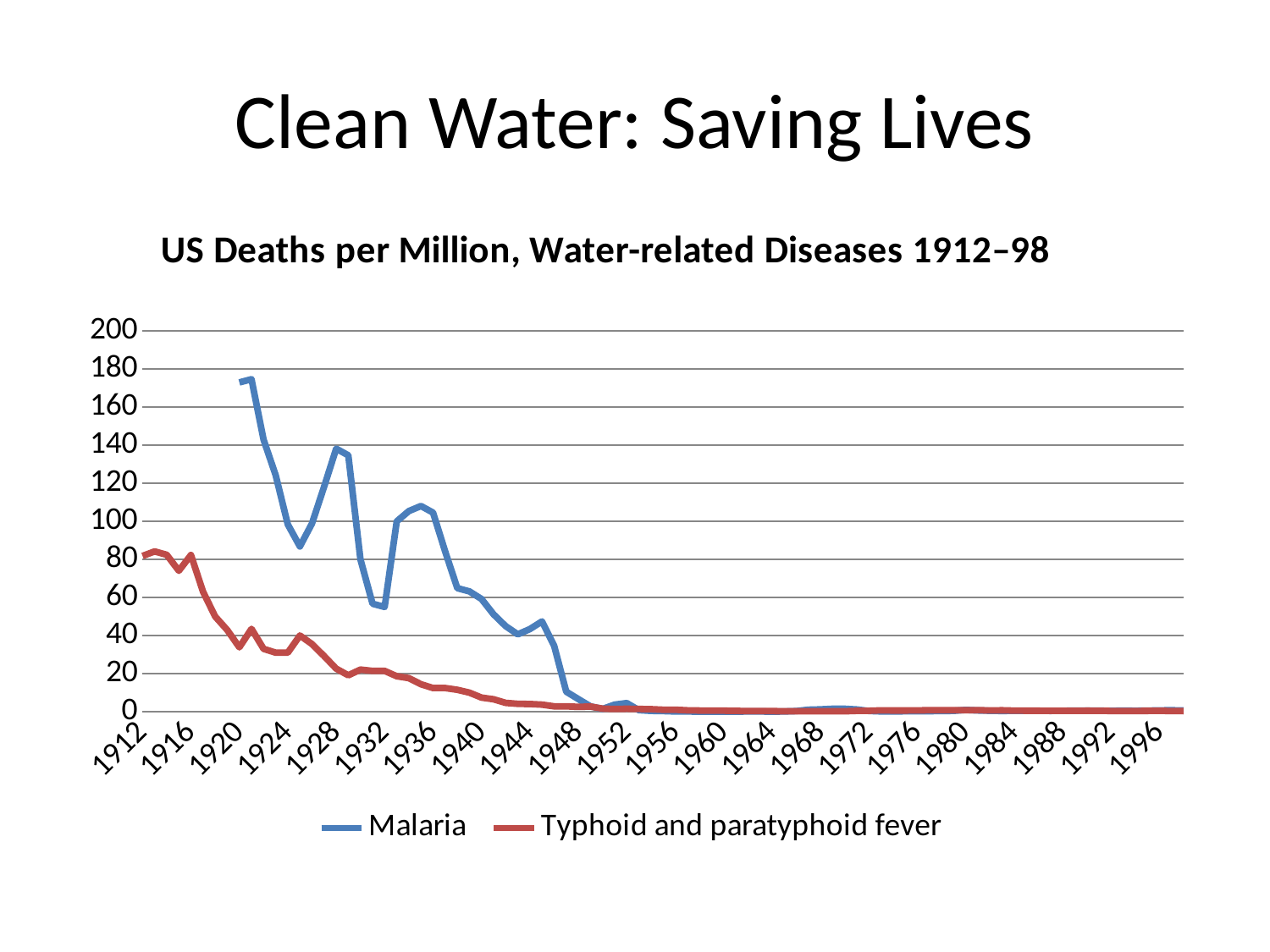
Which series is drawn in blue? Malaria How many series does the legend list? 2 What is the title of the chart? US Deaths per Million, Water-related Diseases 1912–98 Is the Malaria value in 1920 greater or less than 160? greater Do the Typhoid and paratyphoid fever values overall rise or fall from 1912 to 1996? fall What kind of chart is shown on the slide? line chart Do the Malaria values overall rise or fall from 1920 to 1996? fall Which series reaches the highest value on the chart? Malaria Is the Malaria value in 1932 greater or less than 80? less Is the Typhoid and paratyphoid fever value in 1940 greater or less than 20? less In 1936, which series has the larger value, Malaria or Typhoid and paratyphoid fever? Malaria